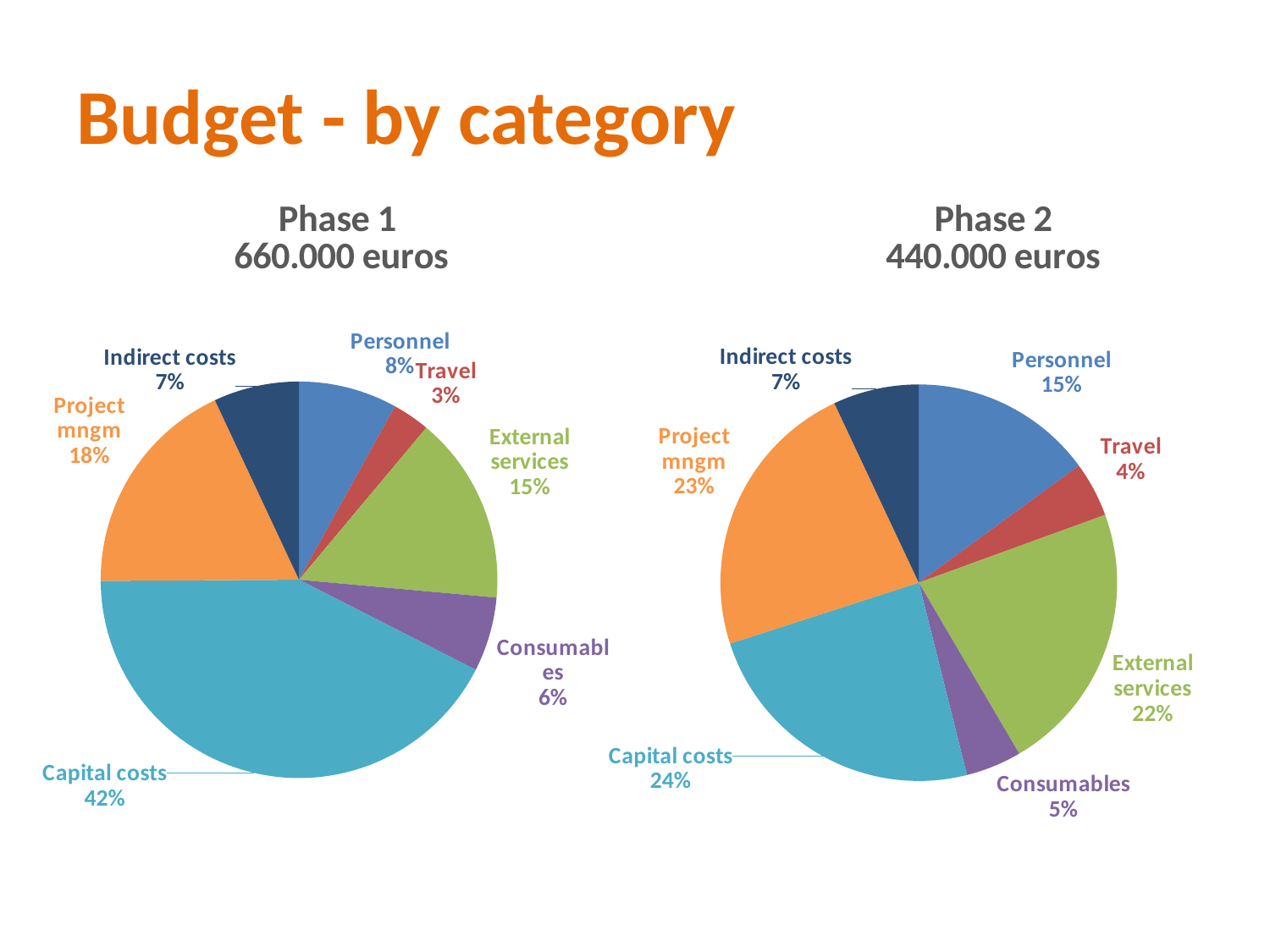
In the Phase 2 pie chart, which category has the largest share? Capital costs In the Phase 1 pie chart, what share of the budget goes to Indirect costs? 7% In the Phase 2 pie chart, what is the difference in percentage points between Project mngm and Personnel? 8 What is the total budget shown in the title of the Phase 2 chart? 440.000 euros In the Phase 2 pie chart, which category has the smallest share? Travel In the Phase 1 pie chart, which category has the largest share? Capital costs What type of chart is used for Phase 1? Pie chart In the Phase 1 pie chart, which is larger: Project mngm or External services? Project mngm In the Phase 1 pie chart, what share of the budget goes to Capital costs? 42% In the Phase 1 pie chart, which category has the smallest share? Travel How many categories are shown in the Phase 2 pie chart? 7 In the Phase 2 pie chart, what share of the budget goes to External services? 22%